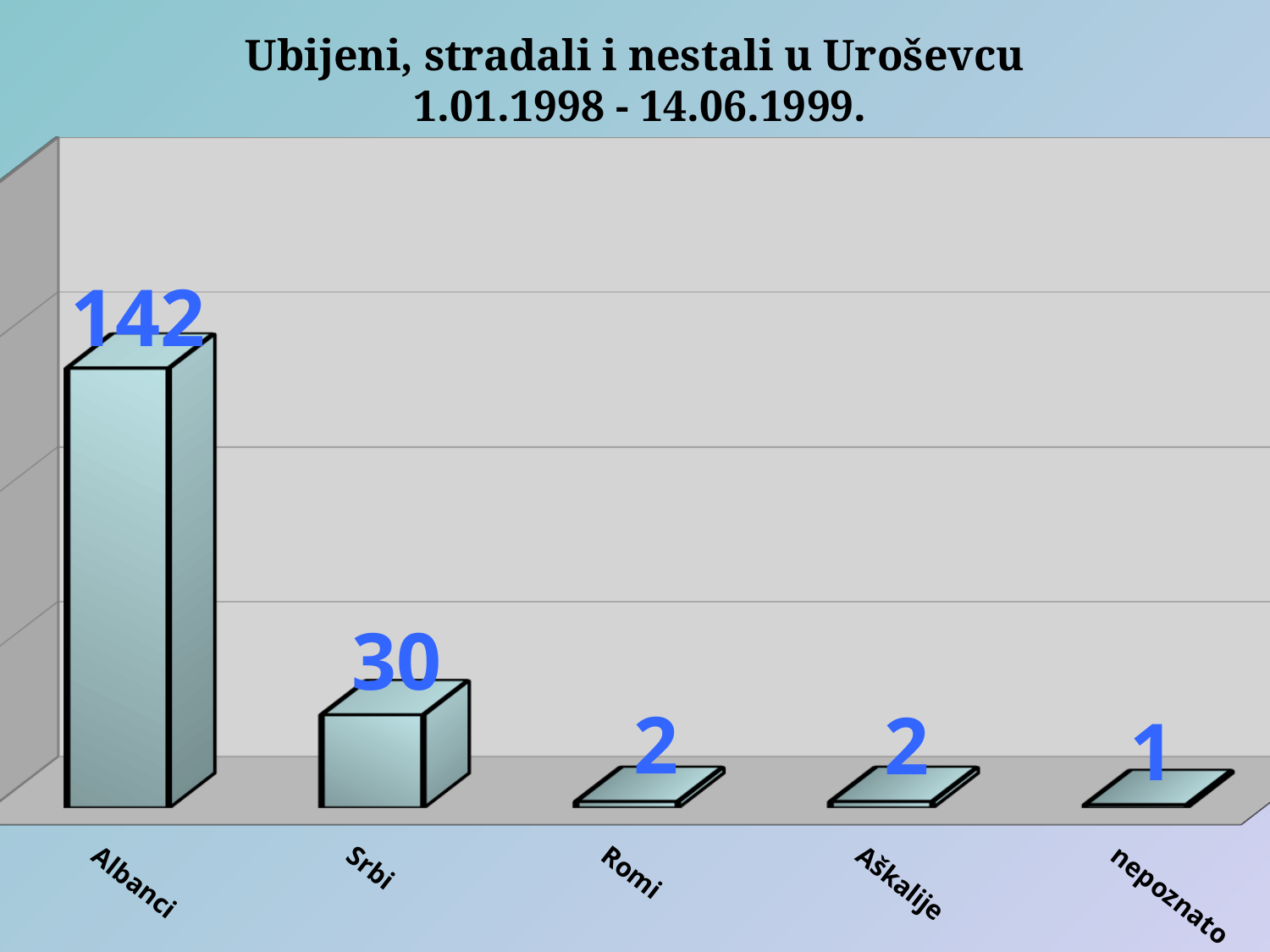
Which is larger, the value for Srbi or the value for Aškalije? Srbi Do the values rise or fall from left to right along the x axis? fall Which category has the lowest value? nepoznato What is the value for Srbi? 30 How many categories are shown on the x axis? 5 Which category has the highest value? Albanci What is the difference between the values for Albanci and Srbi? 112 What kind of chart is this? bar chart What is the value for nepoznato? 1 What is the value for Albanci? 142 What is the title of the chart? Ubijeni, stradali i nestali u Uroševcu 1.01.1998 - 14.06.1999. What is the value for Romi? 2